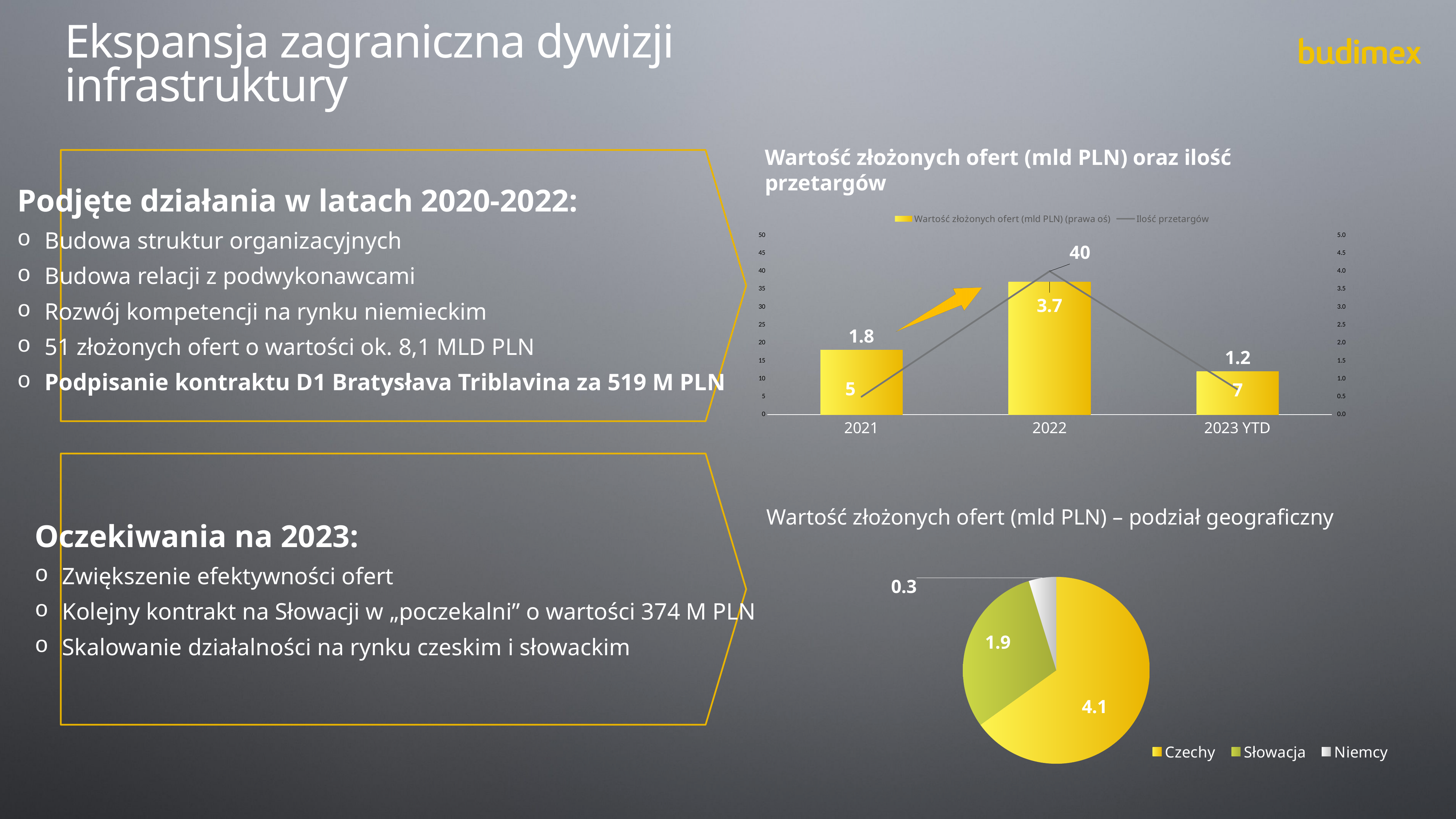
What kind of chart is 'Wartość złożonych ofert (mld PLN) – podział geograficzny'? pie chart In the chart 'Wartość złożonych ofert (mld PLN) oraz ilość przetargów', is the value of submitted offers for 2021 larger or smaller than for 2023 YTD? larger In the chart 'Wartość złożonych ofert (mld PLN) oraz ilość przetargów', what is the difference in the number of tenders between 2022 and 2023 YTD? 33 In the chart 'Wartość złożonych ofert (mld PLN) oraz ilość przetargów', how many tenders (ilość przetargów) are shown for 2021? 5 In the chart 'Wartość złożonych ofert (mld PLN) oraz ilość przetargów', what is the value of submitted offers (mld PLN) for 2022? 3.7 In the chart 'Wartość złożonych ofert (mld PLN) oraz ilość przetargów', how many series does the legend list? 2 In the pie chart 'Wartość złożonych ofert (mld PLN) – podział geograficzny', what is the value for Słowacja? 1.9 In the pie chart 'Wartość złożonych ofert (mld PLN) – podział geograficzny', what is the difference between the values for Czechy and Słowacja? 2.2 In the pie chart 'Wartość złożonych ofert (mld PLN) – podział geograficzny', which country has the smallest slice? Niemcy In the chart 'Wartość złożonych ofert (mld PLN) oraz ilość przetargów', how many categories are shown on the x axis? 3 In the chart 'Wartość złożonych ofert (mld PLN) oraz ilość przetargów', which year has the highest value of submitted offers? 2022 In the chart 'Wartość złożonych ofert (mld PLN) oraz ilość przetargów', which category has the lowest number of tenders? 2021